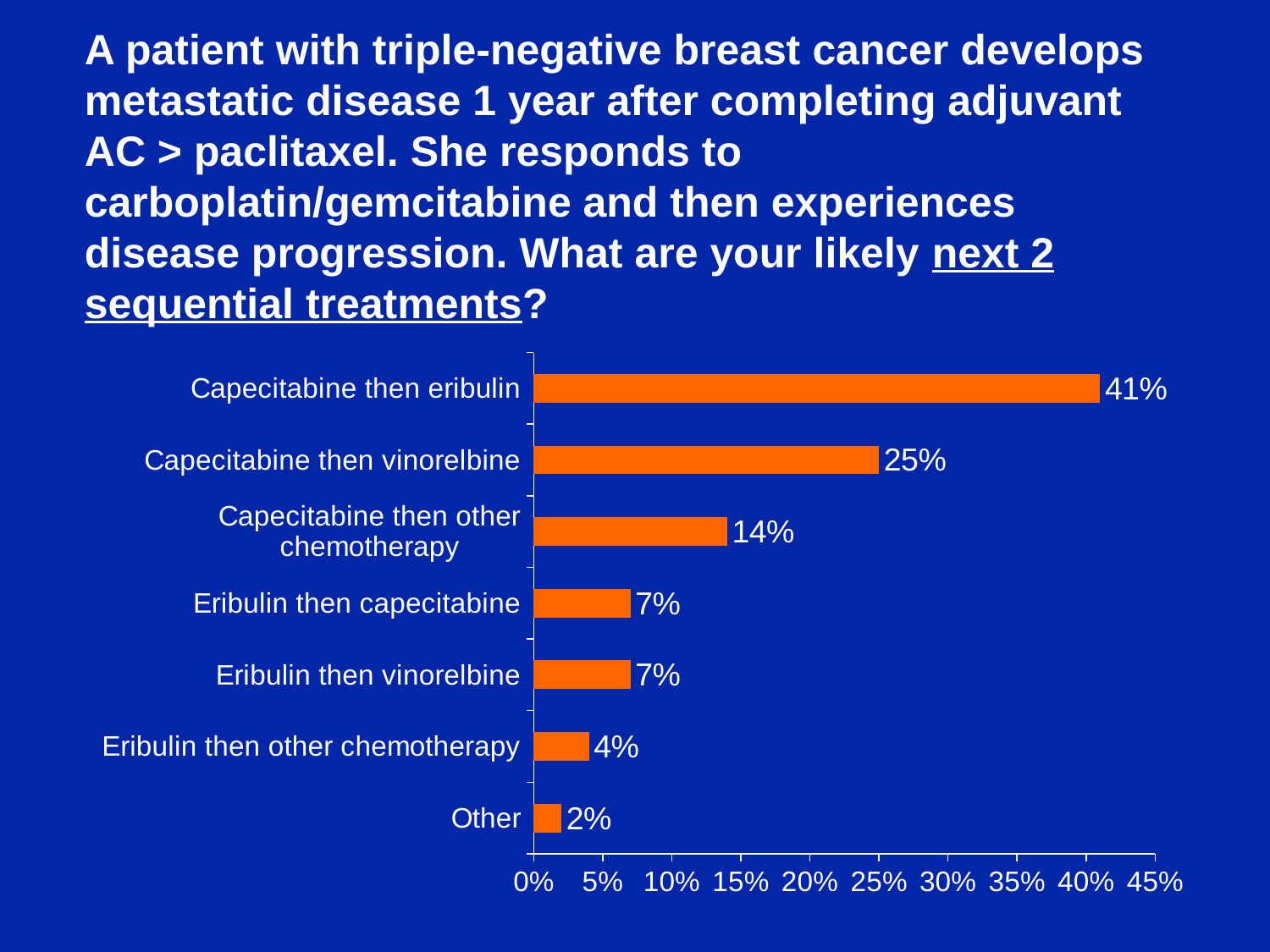
What is the maximum value shown on the x axis? 45% What kind of chart is shown on the slide? Bar chart Is the value for capecitabine then eribulin greater or less than 40%? greater Which treatment sequence has the highest percentage? Capecitabine then eribulin What is the difference between capecitabine then eribulin and capecitabine then vinorelbine? 16% Which is larger: capecitabine then other chemotherapy or eribulin then capecitabine? Capecitabine then other chemotherapy What is the difference between capecitabine then vinorelbine and eribulin then vinorelbine? 18% What is the value for eribulin then other chemotherapy? 4% Which category has the lowest percentage? Other How many treatment categories are shown in the chart? 7 What is the value for capecitabine then other chemotherapy? 14% What percentage of respondents chose capecitabine then eribulin? 41%